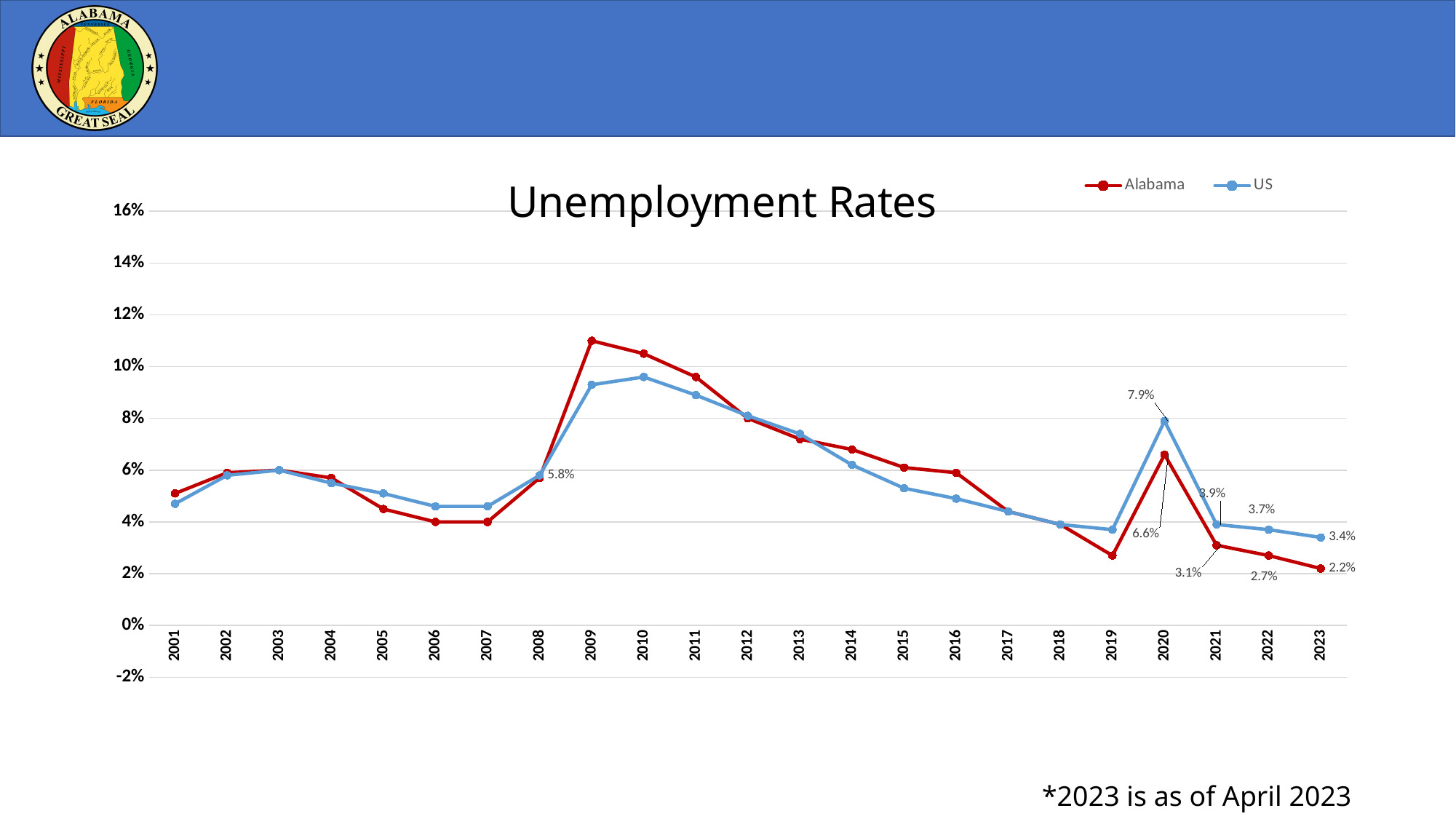
What is the Alabama unemployment rate for 2021? 3.1% How many series does the legend list? 2 Is the Alabama unemployment rate for 2009 greater or less than 10%? greater How many years are plotted along the x axis? 23 What is the US unemployment rate for 2020? 7.9% In 2020, which series has the higher unemployment rate, Alabama or US? US What kind of chart is shown on the slide? Line chart In which year is the Alabama unemployment rate highest? 2009 What is the Alabama unemployment rate for 2023? 2.2% What is the difference between the US and Alabama unemployment rates in 2023? 1.2 percentage points In which year is the Alabama unemployment rate lowest? 2023 Does the Alabama unemployment rate rise or fall from 2020 to 2023? Fall